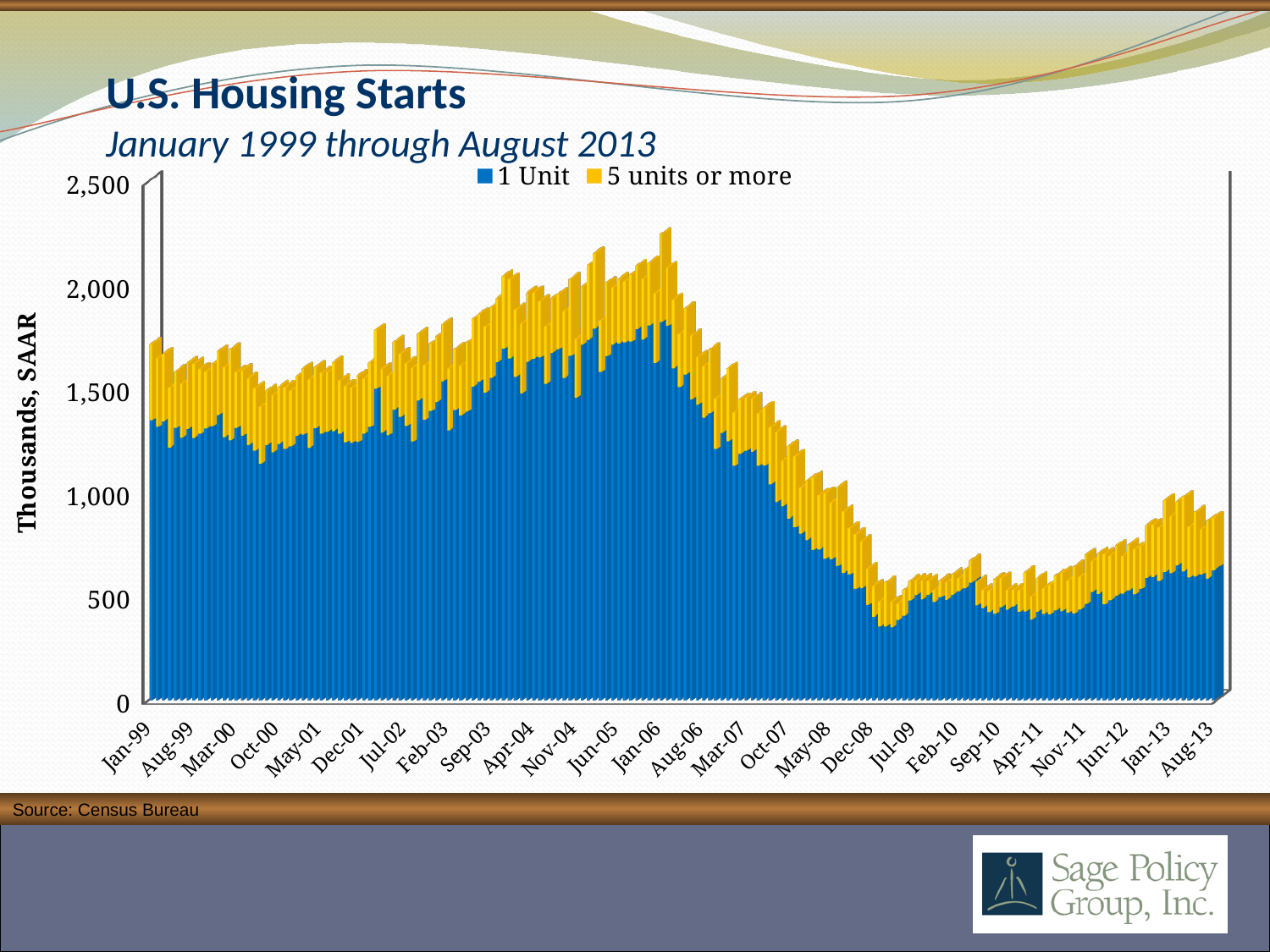
Is the total housing starts value for Jan-06 greater or less than 2,000? greater Is the total housing starts value for Jan-99 greater or less than 1,500? greater Is the 1 Unit value for Apr-11 greater or less than 500? less How many series does the legend list? 2 Do total housing starts rise or fall between Jan-06 and Jul-09? fall What are the two series named in the legend? 1 Unit; 5 units or more Which is larger, the total housing starts for Jan-06 or for Aug-13? Jan-06 What kind of chart is shown on the slide? Stacked bar chart What is the label on the vertical axis? Thousands, SAAR Near which labeled month on the x axis do total housing starts reach their highest level? Jan-06